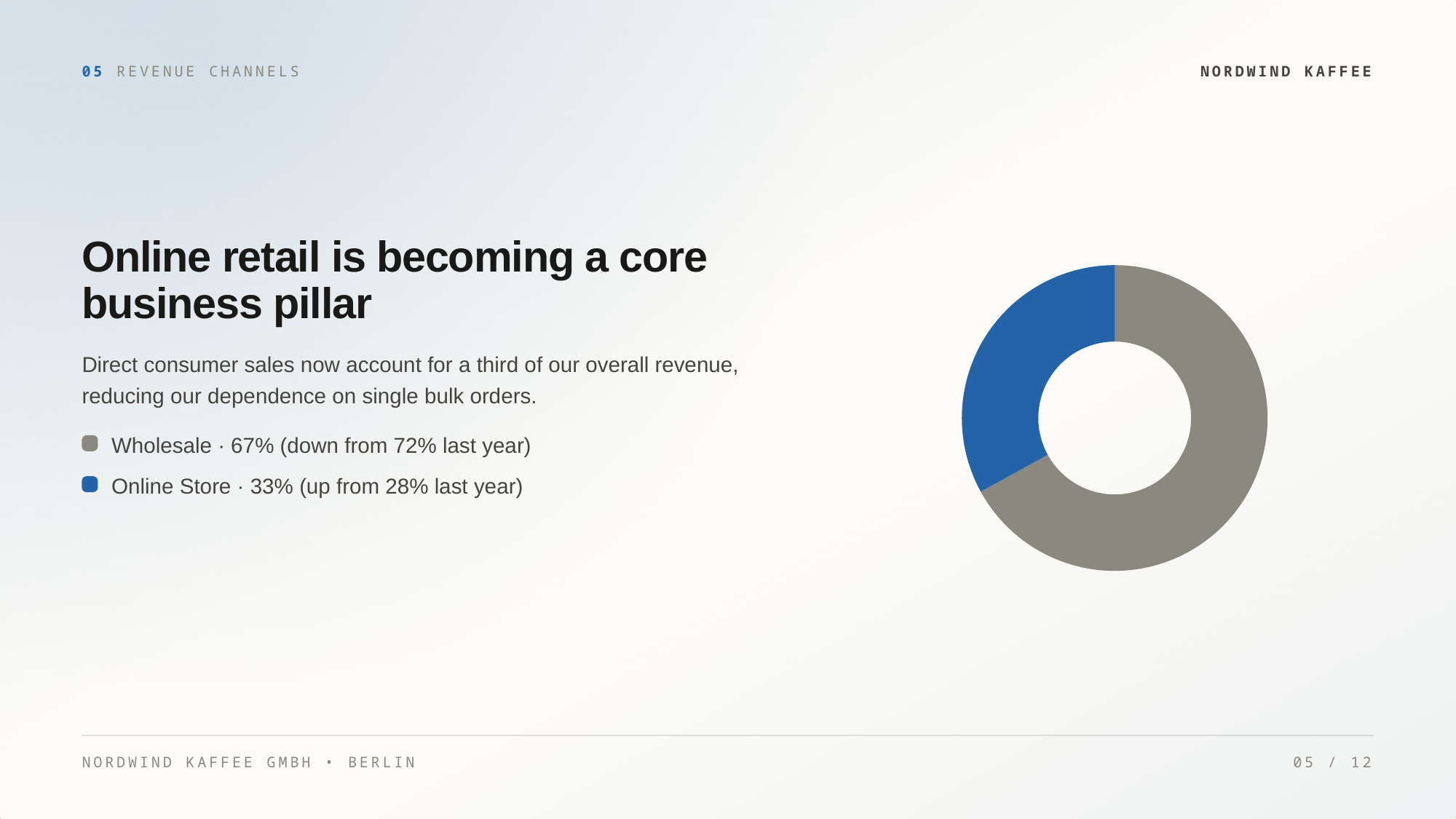
How many slices does the donut chart have? 2 What share of revenue does the Online Store account for? 33% What kind of chart is shown on the slide? Donut chart Which colour represents the Wholesale slice in the donut chart? Grey What was the Wholesale share last year, according to the slide? 72% Which is larger, the Wholesale share or the Online Store share? Wholesale What was the Online Store share last year, according to the slide? 28% Which revenue channel has the smallest share? Online Store What share of revenue does Wholesale account for? 67% Which revenue channel has the largest share? Wholesale What is the difference in percentage points between the Wholesale share and the Online Store share? 34 percentage points Which colour represents the Online Store slice in the donut chart? Blue